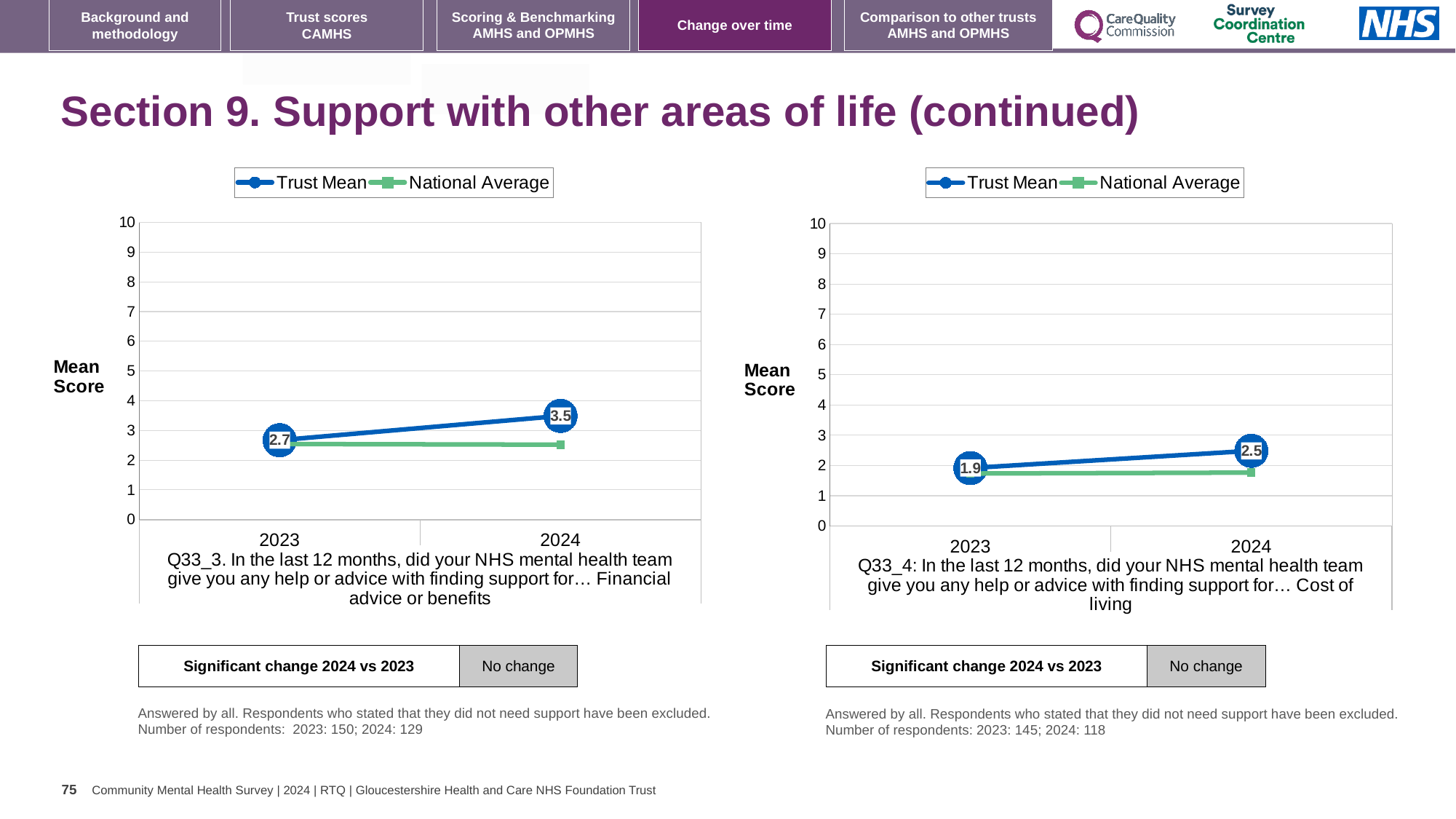
What type of chart is the right chart (Q33_4, Cost of living)? line chart In the right chart (Q33_4, Cost of living), what is the Trust Mean for 2023? 1.9 In the right chart (Q33_4, Cost of living), what is the Trust Mean for 2024? 2.5 In the left chart (Q33_3, Financial advice or benefits), what is the Trust Mean for 2023? 2.7 In the left chart (Q33_3, Financial advice or benefits), does the Trust Mean rise or fall from 2023 to 2024? rise In the left chart (Q33_3, Financial advice or benefits), by how much did the Trust Mean change from 2023 to 2024? 0.8 In the left chart (Q33_3, Financial advice or benefits), is the Trust Mean for 2024 greater or less than 3? greater How many series does the legend of the left chart list? 2 In the right chart (Q33_4, Cost of living), what is the difference between the Trust Mean in 2024 and in 2023? 0.6 In the left chart (Q33_3, Financial advice or benefits), what is the Trust Mean for 2024? 3.5 In the right chart (Q33_4, Cost of living), is the National Average for 2024 greater or less than 2? less In the right chart (Q33_4, Cost of living), which is larger in 2024, the Trust Mean or the National Average? Trust Mean